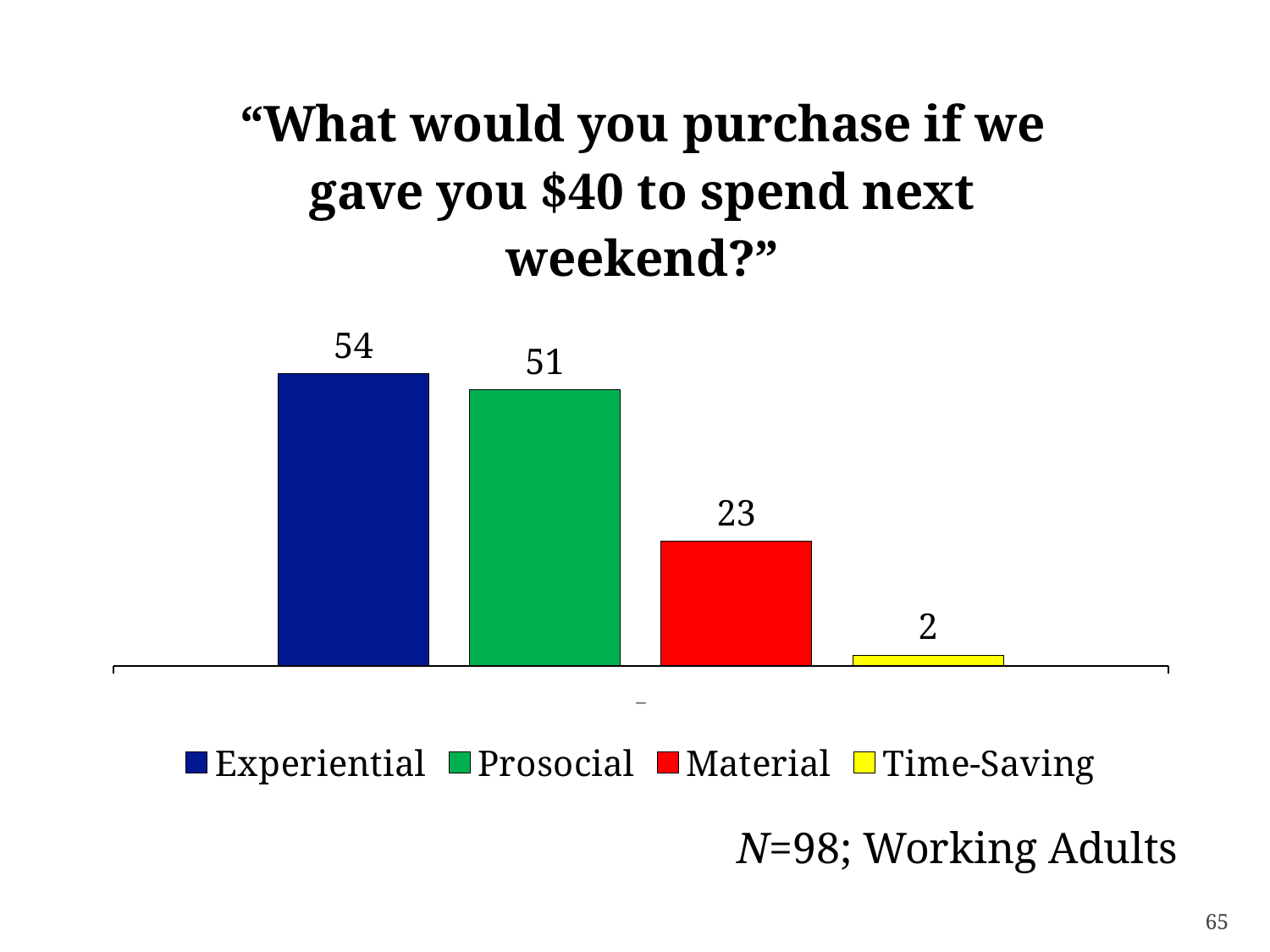
What kind of chart is shown on the slide? Bar chart Which category has the highest value? Experiential What is the value for Experiential? 54 How many categories are shown in the chart? 4 What is the value for Time-Saving? 2 What is the value for Material? 23 What is the difference between the values for Experiential and Material? 31 What is the difference between the values for Prosocial and Time-Saving? 49 Which is larger, the value for Material or the value for Time-Saving? Material What is the value for Prosocial? 51 Which category has the lowest value? Time-Saving What colour is the bar for Prosocial? Green